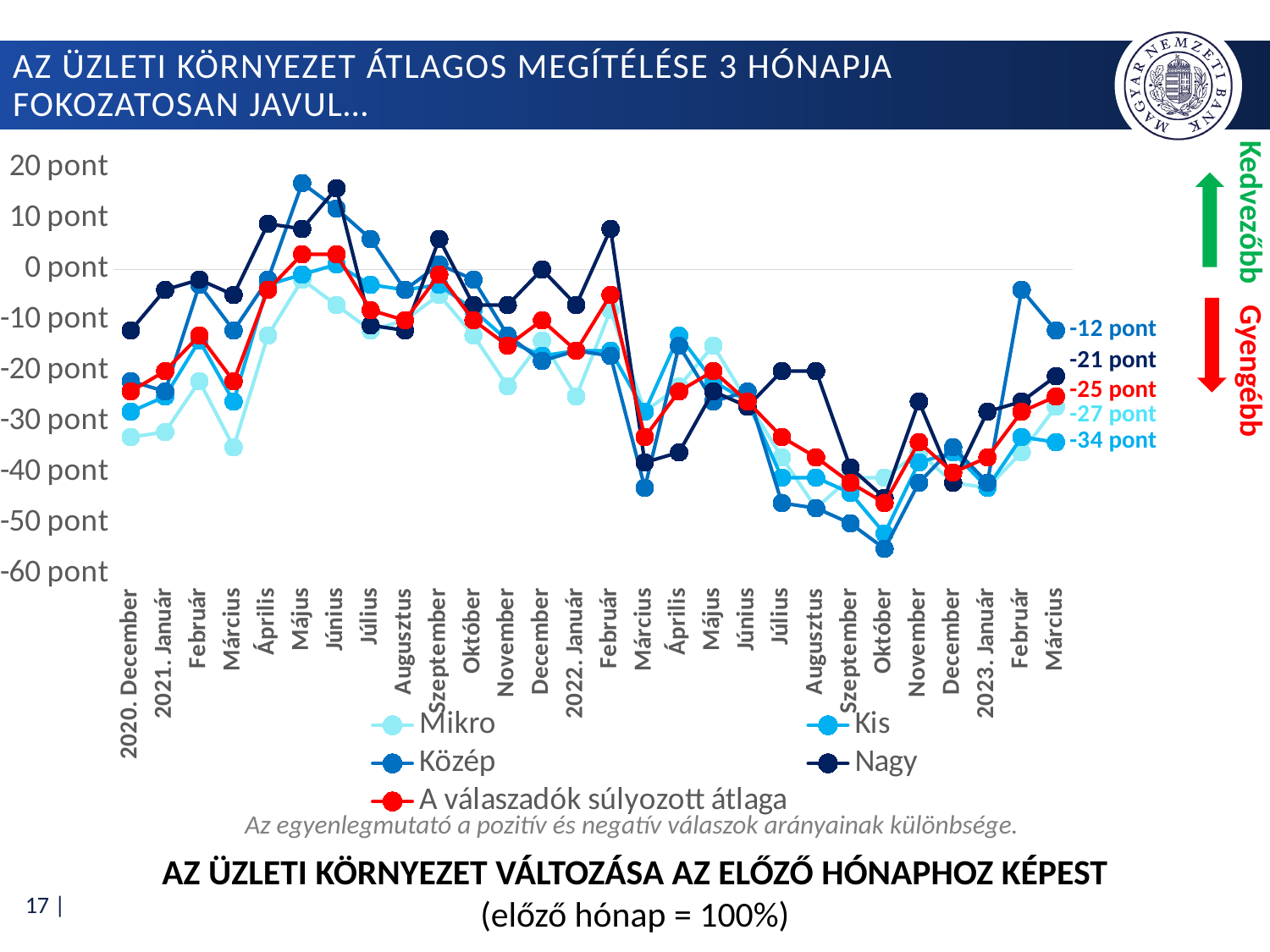
What is the difference between the Közép and Kis values in 2023 Március? 22 pont Which series has the highest value in 2023 Március? Közép What kind of chart is shown on the slide? line chart What is the value for A válaszadók súlyozott átlaga in 2023 Március? -25 pont What is the value for Mikro in 2023 Március? -27 pont How many series does the legend list? 5 How many months are plotted along the x axis? 28 Which series has the lowest value in 2023 Március? Kis Is the value for Közép in 2021 Május greater or less than 10 pont? greater What is the value for Nagy in 2023 Március? -21 pont What is the value for Kis in 2023 Március? -34 pont What is the value for Közép in 2023 Március? -12 pont